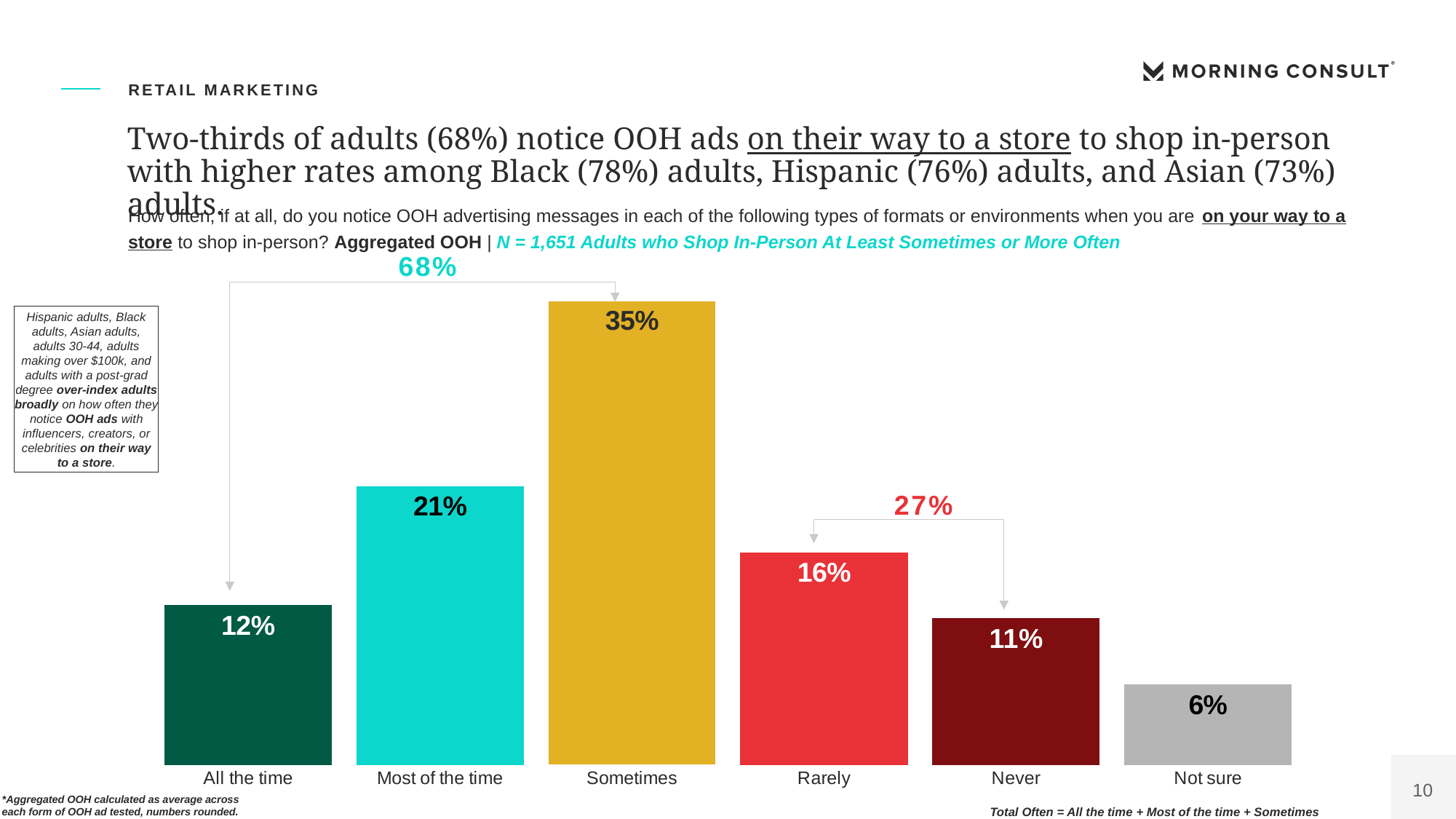
Which category has the highest value? Sometimes What is the value for "Not sure"? 6% What is the sample size (N) stated for the chart? 1,651 What is the difference between the values for "Sometimes" and "Most of the time"? 14% What combined percentage is shown by the bracket spanning "Rarely" and "Never"? 27% Which is larger, the value for "Rarely" or the value for "Never"? Rarely Which category has the lowest value? Not sure What combined percentage is shown by the bracket spanning "All the time" through "Sometimes"? 68% What is the value for "Sometimes"? 35% How many categories are shown on the x axis? 6 What kind of chart is shown on the slide? Bar chart What is the value for "All the time"? 12%